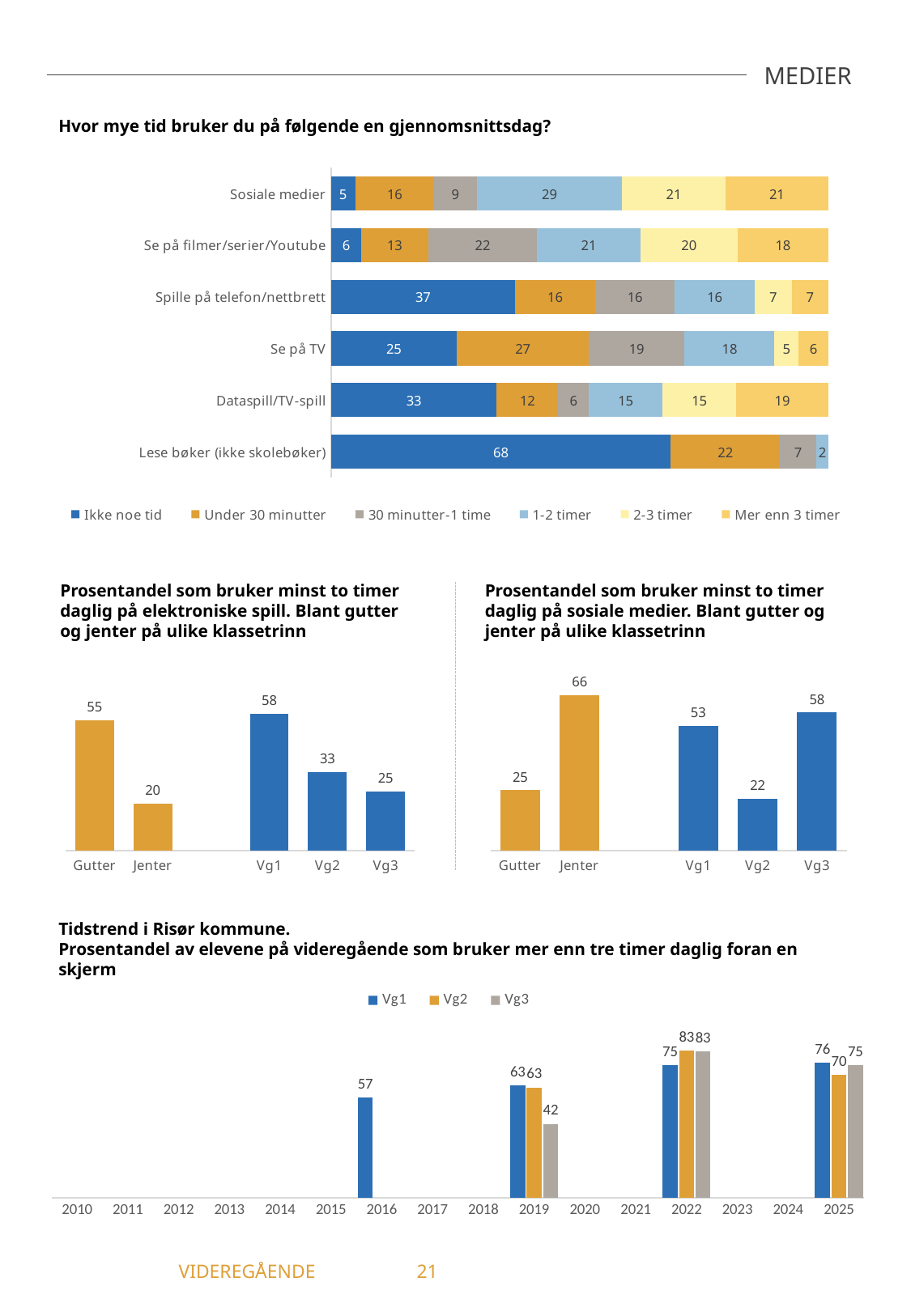
In the top chart 'Hvor mye tid bruker du på følgende en gjennomsnittsdag?', what is the value for '1-2 timer' for 'Sosiale medier'? 29 In the top chart 'Hvor mye tid bruker du på følgende en gjennomsnittsdag?', which activity has the highest value for 'Ikke noe tid'? Lese bøker (ikke skolebøker) In the chart 'Prosentandel som bruker minst to timer daglig på elektroniske spill', what is the difference between Vg1 and Vg3? 33 In the top chart 'Hvor mye tid bruker du på følgende en gjennomsnittsdag?', what is the value for 'Ikke noe tid' for 'Lese bøker (ikke skolebøker)'? 68 In the chart 'Prosentandel som bruker minst to timer daglig på sosiale medier', which category has the highest value? Jenter In the chart 'Prosentandel som bruker minst to timer daglig på sosiale medier', which is larger, Vg1 or Vg3? Vg3 In the top chart 'Hvor mye tid bruker du på følgende en gjennomsnittsdag?', how many activity categories are shown? 6 In the top chart 'Hvor mye tid bruker du på følgende en gjennomsnittsdag?', how many series does the legend list? 6 In the bottom chart 'Tidstrend i Risør kommune', what is the value for Vg3 in 2019? 42 In the chart 'Prosentandel som bruker minst to timer daglig på sosiale medier', what is the value for Vg2? 22 In the chart 'Prosentandel som bruker minst to timer daglig på elektroniske spill', what is the value for Gutter? 55 What type of chart is the bottom chart 'Tidstrend i Risør kommune'? Bar chart